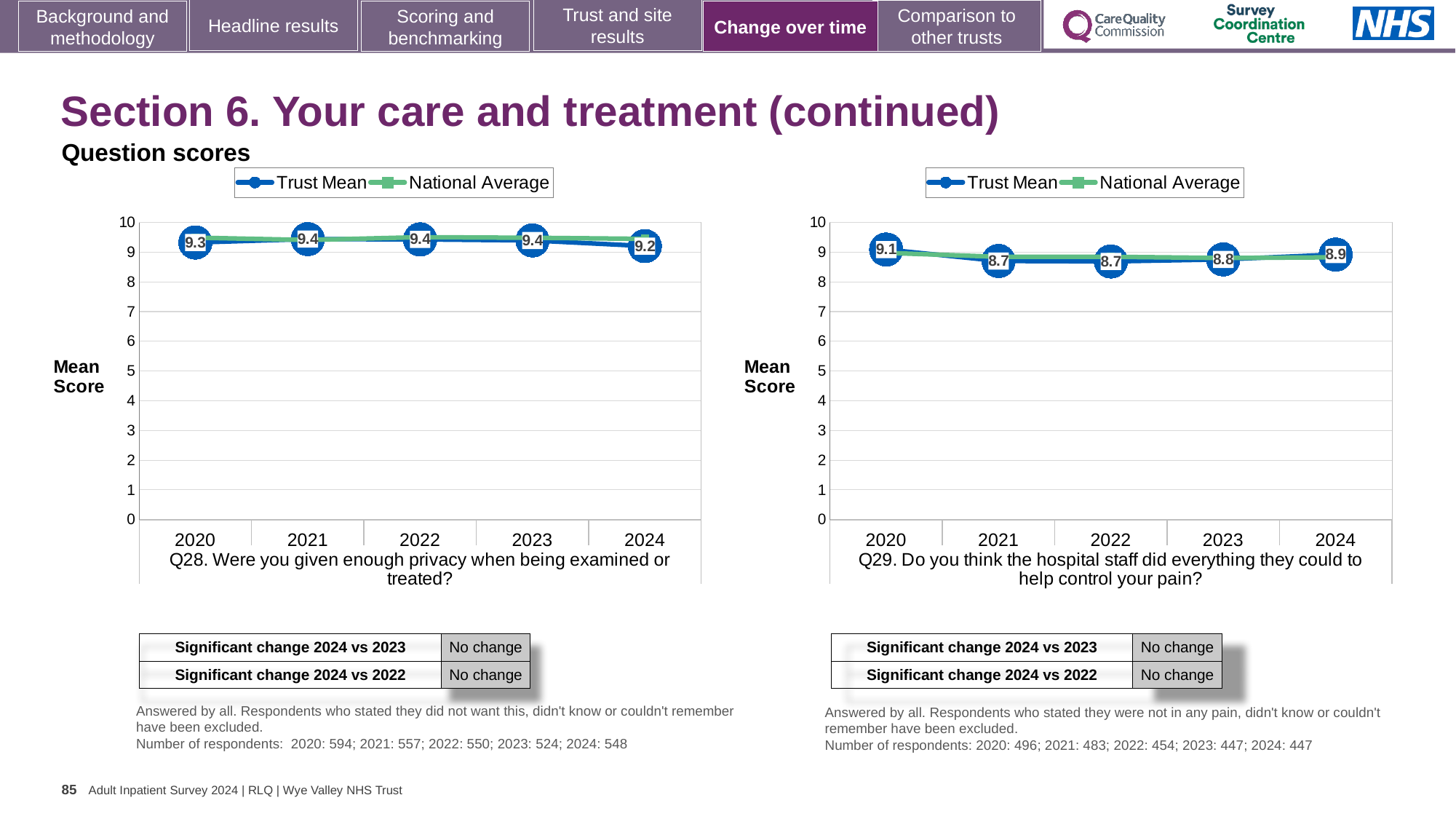
How many years are plotted on the x axis of the Q28 chart (left)? 5 In the Q29 chart (right), what is the Trust Mean score for 2020? 9.1 How many series does the legend of the Q29 chart (right) list? 2 In the Q29 chart (right), what is the Trust Mean score for 2023? 8.8 In the Q29 chart (right), is the Trust Mean score for 2024 larger or smaller than the score for 2022? larger In the Q28 chart (left), is the National Average value for 2024 greater or less than 5? greater What type of chart is used for the Q28 chart (left)? Line chart In the Q29 chart (right), which year has the highest Trust Mean score? 2020 In the Q28 chart (left), what is the difference between the Trust Mean scores for 2023 and 2024? 0.2 In the Q29 chart (right), what is the difference between the Trust Mean scores for 2020 and 2021? 0.4 In the Q28 chart (left), which year has the lowest Trust Mean score? 2024 In the Q28 chart (left), what is the Trust Mean score for 2024? 9.2